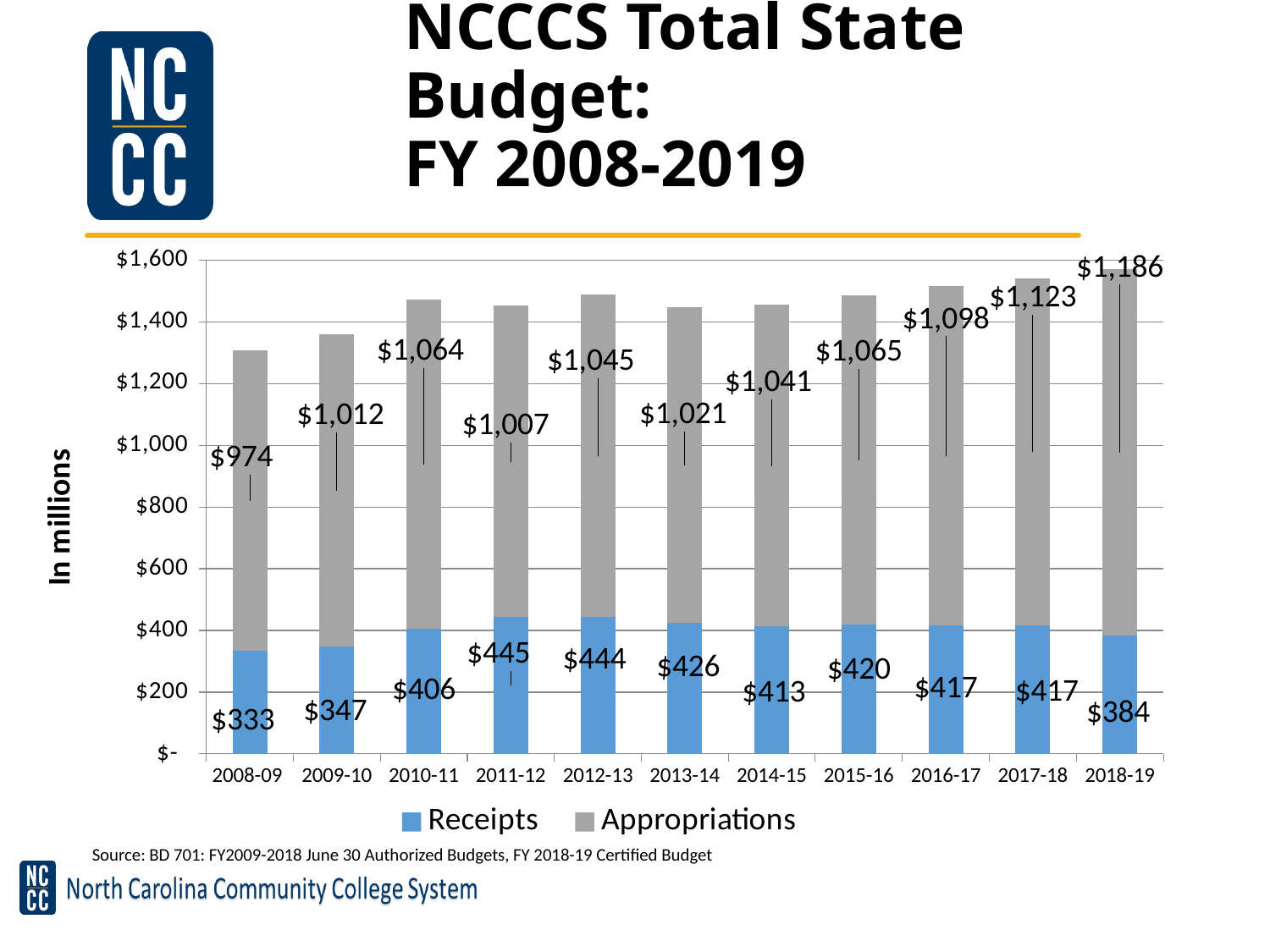
What is the value of Appropriations for 2017-18? $1,123 What is the label on the vertical axis? In millions Is the total stacked bar for 2008-09 greater or less than $1,400? less Which fiscal year has the highest Appropriations value? 2018-19 What is the total of the stacked bar for 2018-19? $1,570 What kind of chart is shown on the slide? stacked bar chart Which fiscal year has the lowest Receipts value? 2008-09 How many series does the legend list? 2 Which is larger, Receipts in 2011-12 or Receipts in 2018-19? 2011-12 What is the value of Receipts for 2008-09? $333 How many fiscal years are shown on the x axis? 11 What is the difference between Appropriations in 2018-19 and 2008-09? $212